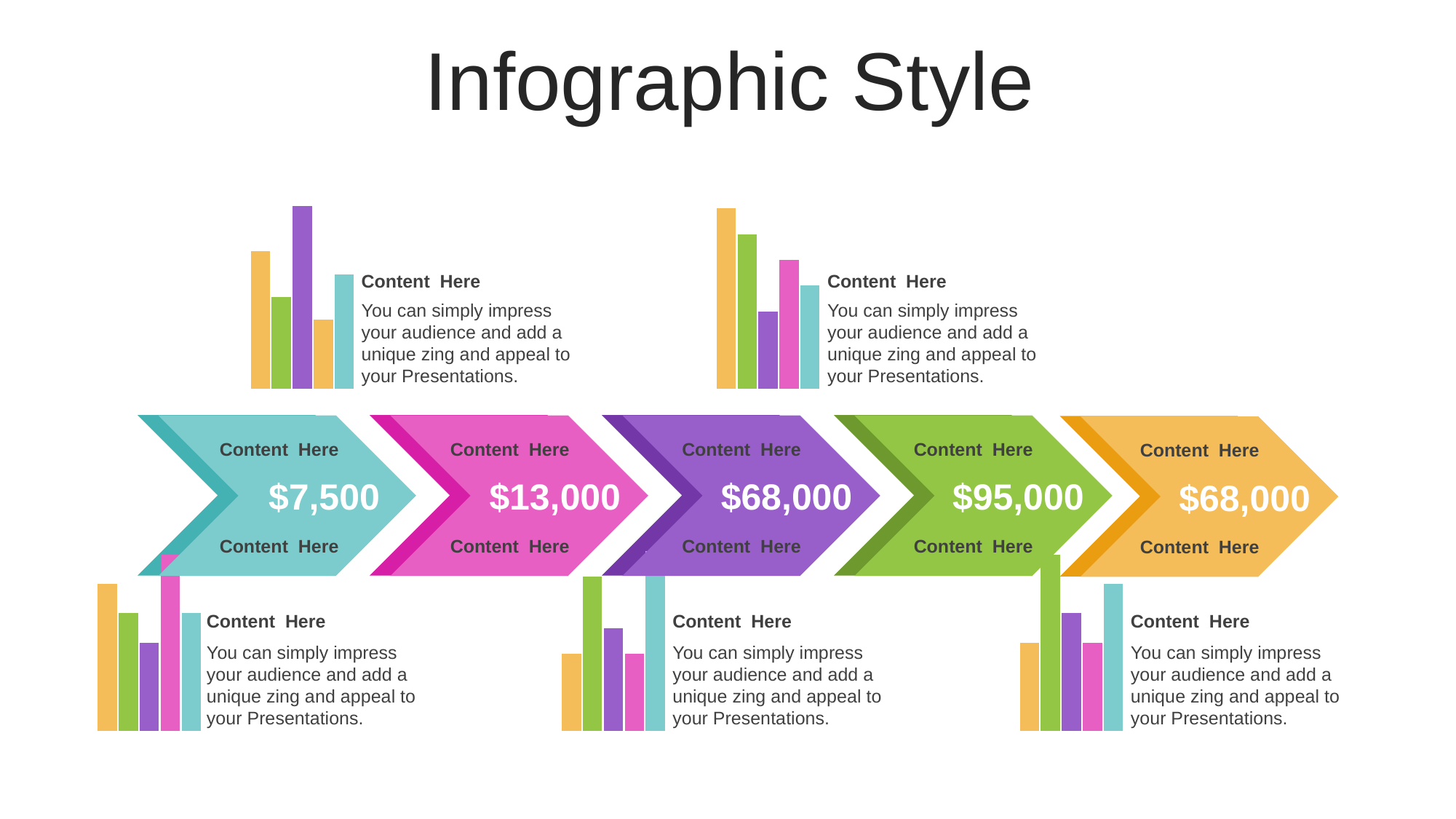
What value is printed on the first (teal) chevron arrow? $7,500 What value is printed on the pink chevron arrow? $13,000 What kind of chart are the five small charts placed above and below the arrow sequence? bar chart How many chevron arrows are in the sequence across the middle of the slide? 5 In the top-right bar chart, which colour bar is the tallest? orange What value is printed on the green chevron arrow? $95,000 Which chevron arrow shows the lowest value? the teal arrow ($7,500) How many bars does the top-left bar chart contain? 5 In the top-left bar chart, which colour bar is the tallest? purple Which chevron arrow shows the highest value? the green arrow ($95,000) How many small bar charts are on the slide? 5 What is the difference between the value on the green chevron arrow and the value on the pink chevron arrow? $82,000